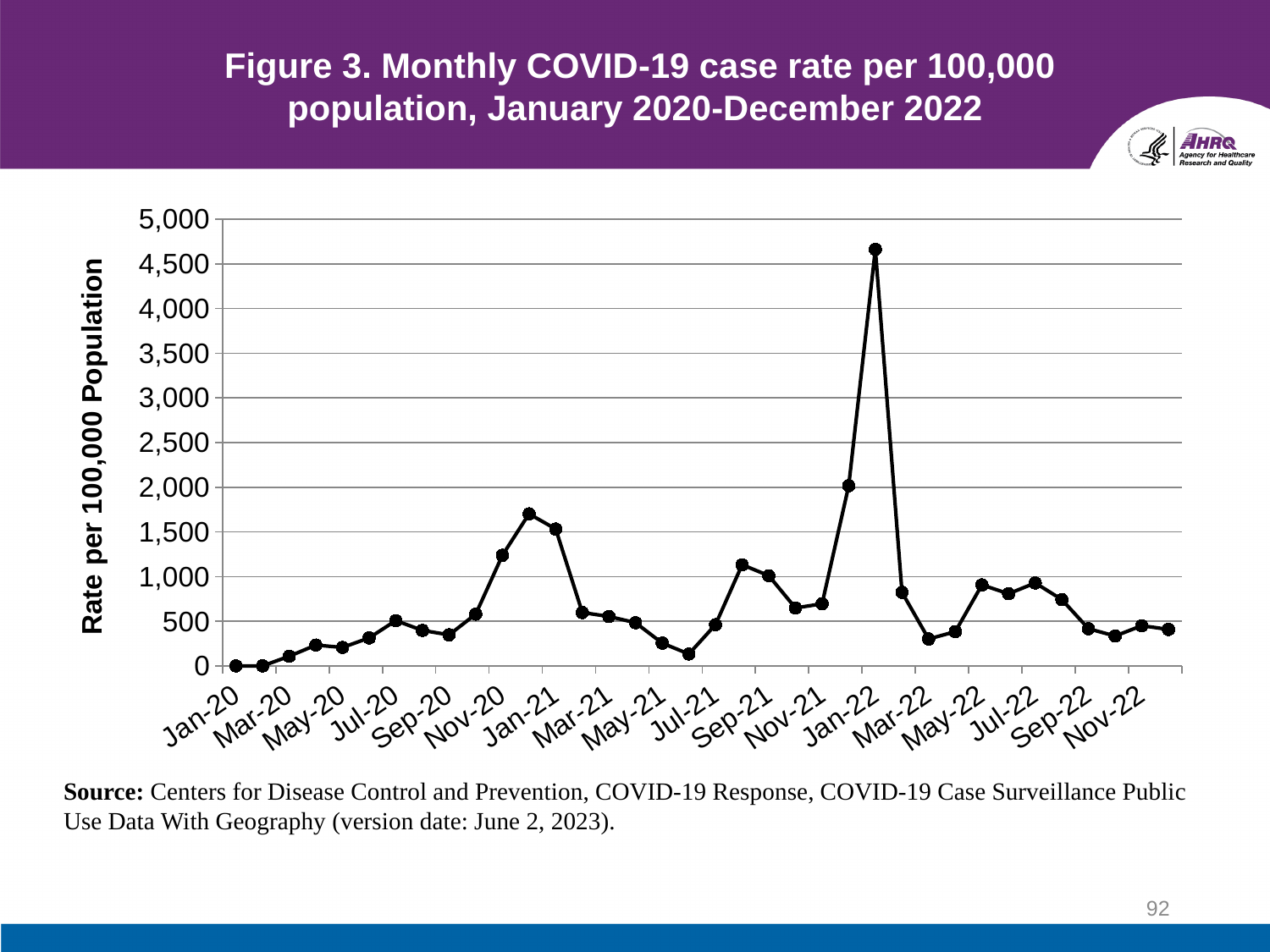
Is the case rate for Jan-22 greater or less than 4,500? greater Which month has the larger case rate, Dec-20 or Sep-21? Dec-20 Which month has the larger case rate, Jul-21 or Sep-21? Sep-21 What is the label on the vertical axis of the chart? Rate per 100,000 Population What kind of chart is shown on the slide? line chart Is the case rate for Mar-22 greater or less than 500? less Is the case rate for Dec-20 greater or less than 1,500? greater Which month has the highest COVID-19 case rate per 100,000 population? Jan-22 Does the case rate rise or fall from Jan-22 to Mar-22? fall Does the case rate rise or fall from Sep-20 to Dec-20? rise